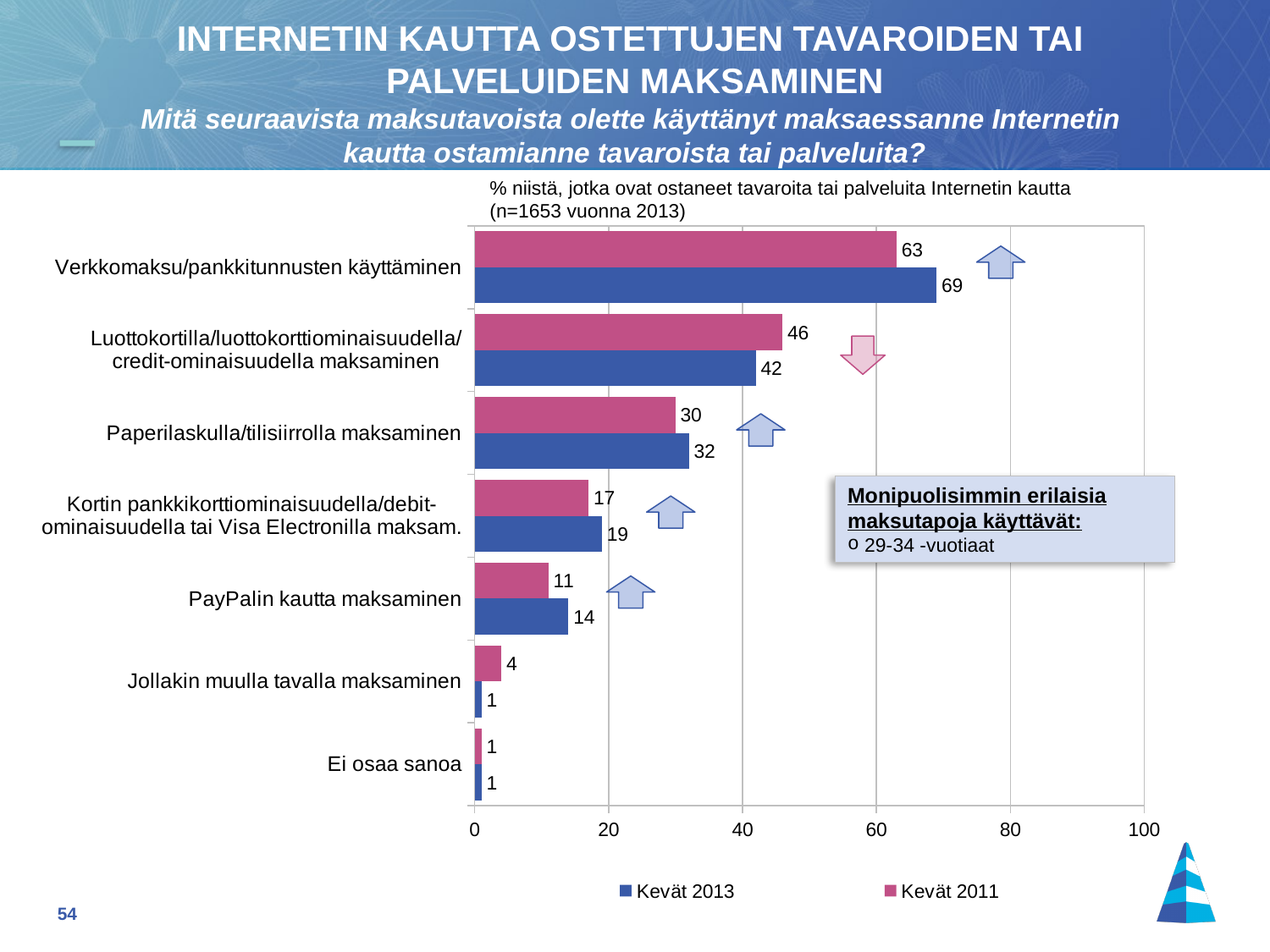
Which category has the highest Kevät 2013 value? Verkkomaksu/pankkitunnusten käyttäminen What is the Kevät 2011 value for Luottokortilla/luottokorttiominaisuudella/credit-ominaisuudella maksaminen? 46 Which is larger for Luottokortilla/luottokorttiominaisuudella/credit-ominaisuudella maksaminen: the Kevät 2013 value or the Kevät 2011 value? Kevät 2011 What is the difference between the Kevät 2013 and Kevät 2011 values for Paperilaskulla/tilisiirrolla maksaminen? 2 What is the Kevät 2013 value for Verkkomaksu/pankkitunnusten käyttäminen? 69 What is the Kevät 2013 value for PayPalin kautta maksaminen? 14 What kind of chart is shown on the slide? Bar chart Which series is shown in blue in the legend? Kevät 2013 What is the Kevät 2011 value for Jollakin muulla tavalla maksaminen? 4 How many categories are shown on the chart? 7 Which category has the lowest Kevät 2011 value? Ei osaa sanoa How many series does the legend list? 2